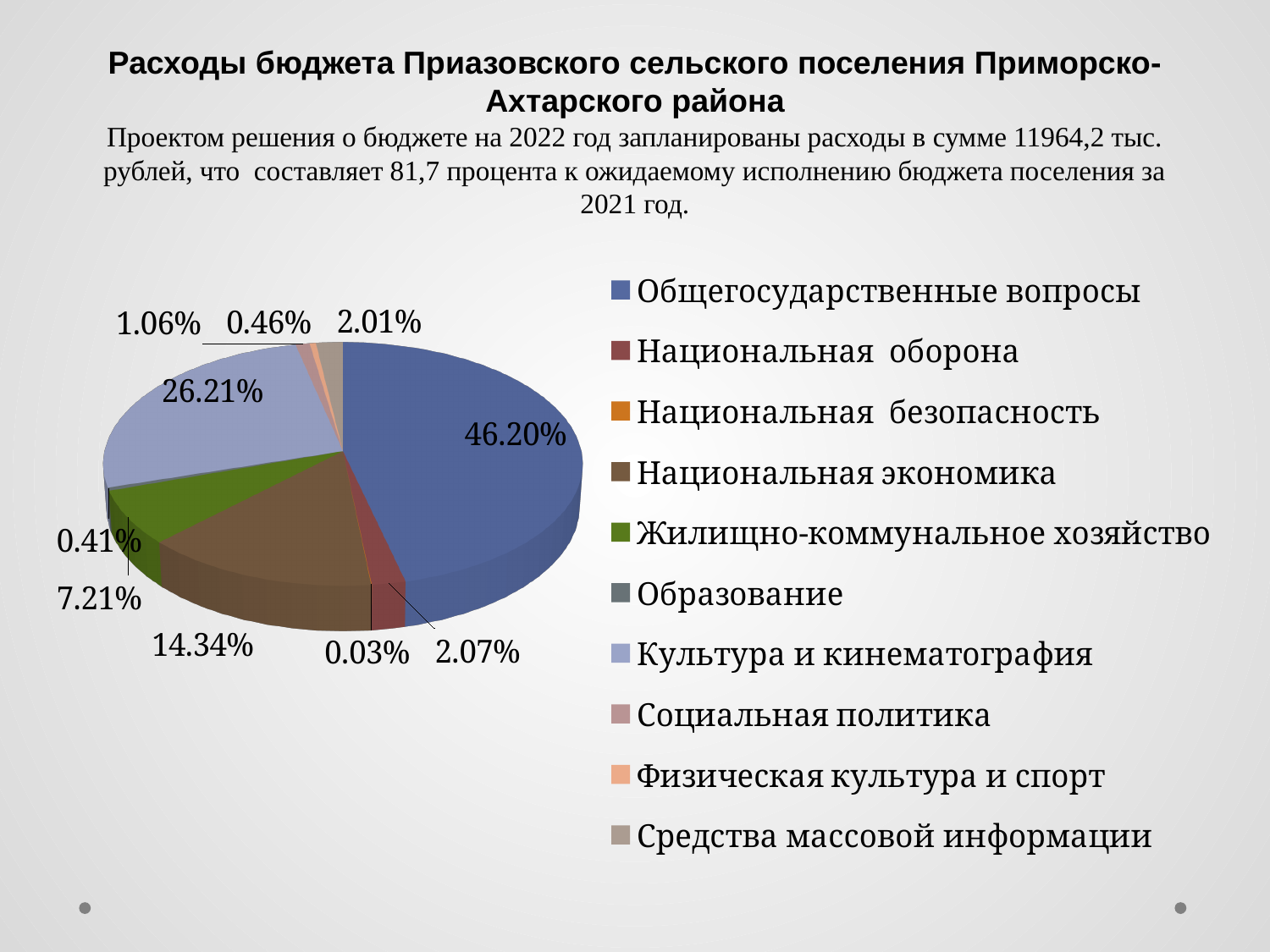
What share of the pie does Общегосударственные вопросы have? 46.20% Which category has the smallest share of the pie? Национальная безопасность What share of the pie does Национальная оборона have? 2.07% What type of chart is shown on the slide? Pie chart What share of the pie does Культура и кинематография have? 26.21% What share of the pie does Национальная экономика have? 14.34% How many categories does the legend of the pie chart list? 10 Which has a larger share: Национальная экономика or Жилищно-коммунальное хозяйство? Национальная экономика What share of the pie does Жилищно-коммунальное хозяйство have? 7.21% What colour is the slice for Жилищно-коммунальное хозяйство? Green What is the difference in percentage points between the shares of Общегосударственные вопросы and Культура и кинематография? 19.99 Which category has the largest share of the pie? Общегосударственные вопросы